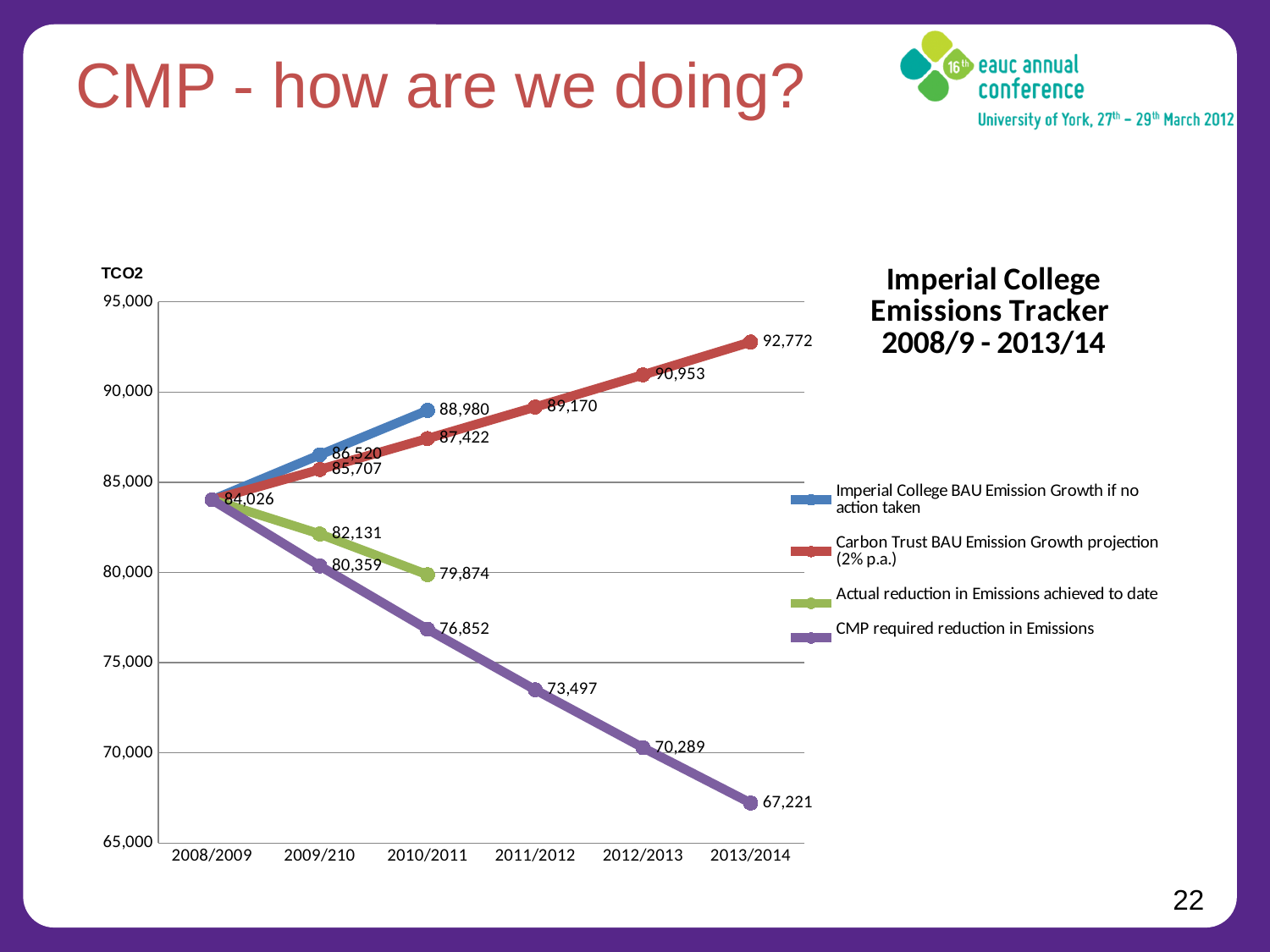
What is the value of the Carbon Trust BAU Emission Growth projection (2% p.a.) series for 2013/2014? 92,772 What is the highest value plotted on the chart? 92,772 What is the lowest value plotted on the chart? 67,221 What is the value of the Actual reduction in Emissions achieved to date series for 2009/210? 82,131 What is the difference between the Actual reduction in Emissions achieved to date and the CMP required reduction in Emissions in 2010/2011? 3,022 What kind of chart is shown on the slide? Line chart What value do all four series share at 2008/2009? 84,026 How many year categories are shown on the x axis? 6 What is the value of the CMP required reduction in Emissions series for 2010/2011? 76,852 Does the CMP required reduction in Emissions series rise or fall from 2008/2009 to 2013/2014? Fall In 2009/210, which is larger: the Imperial College BAU Emission Growth if no action taken value or the Carbon Trust BAU Emission Growth projection value? Imperial College BAU Emission Growth if no action taken How many series does the legend list? 4